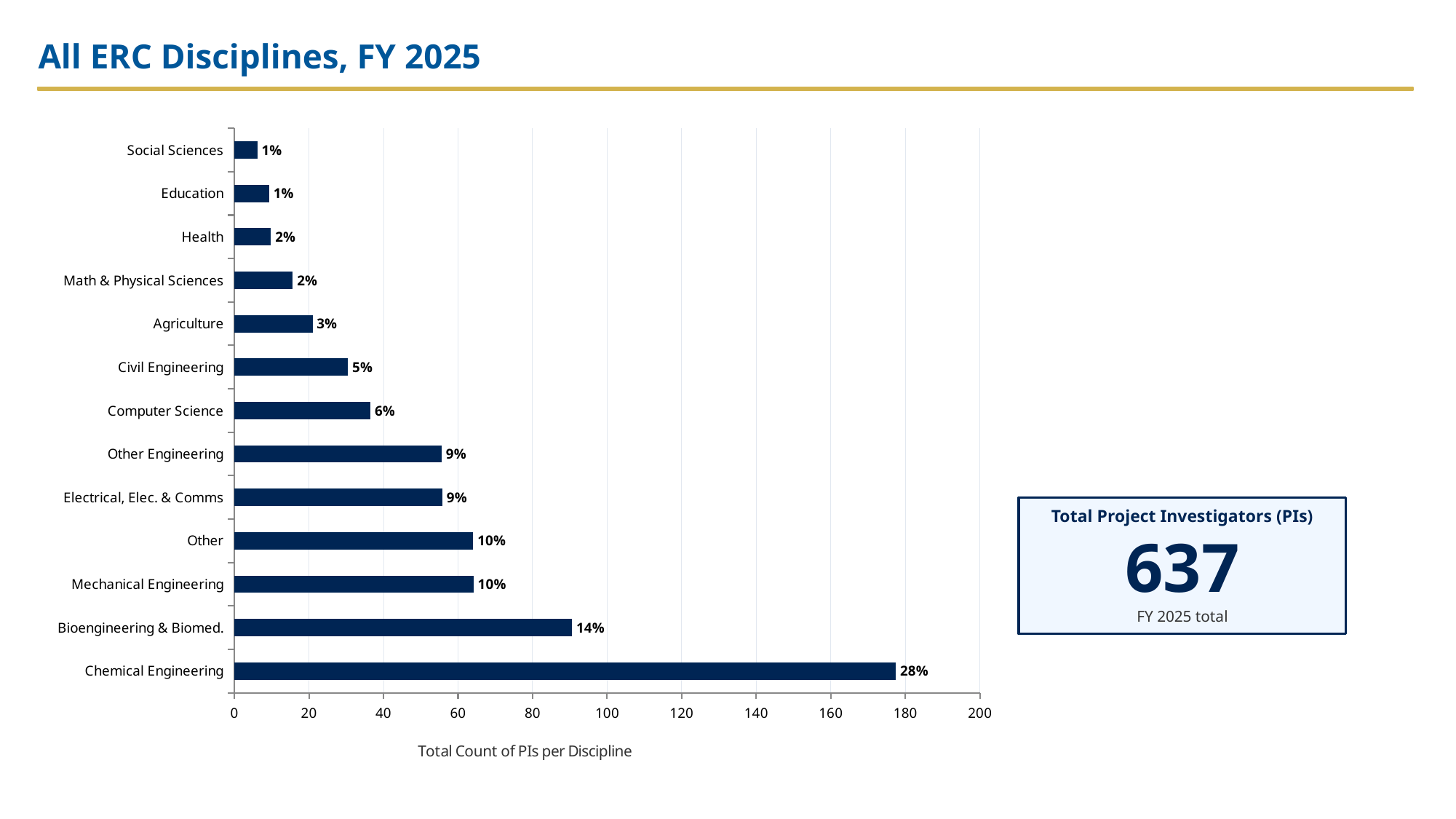
What is the total number of Project Investigators shown in the box on the slide? 637 How many disciplines are plotted in the chart? 13 Is the PI count for Civil Engineering greater or less than 40? less Which has a higher PI count, Mechanical Engineering or Computer Science? Mechanical Engineering Is the PI count for Chemical Engineering greater or less than 160? greater Is the PI count for Bioengineering & Biomed. greater or less than 100? less What kind of chart is shown on the slide? bar chart Which discipline has the highest count of PIs? Chemical Engineering What percentage label is shown for Chemical Engineering? 28% What percentage label is shown for Agriculture? 3% What percentage label is shown for Computer Science? 6% What percentage label is shown for Bioengineering & Biomed.? 14%